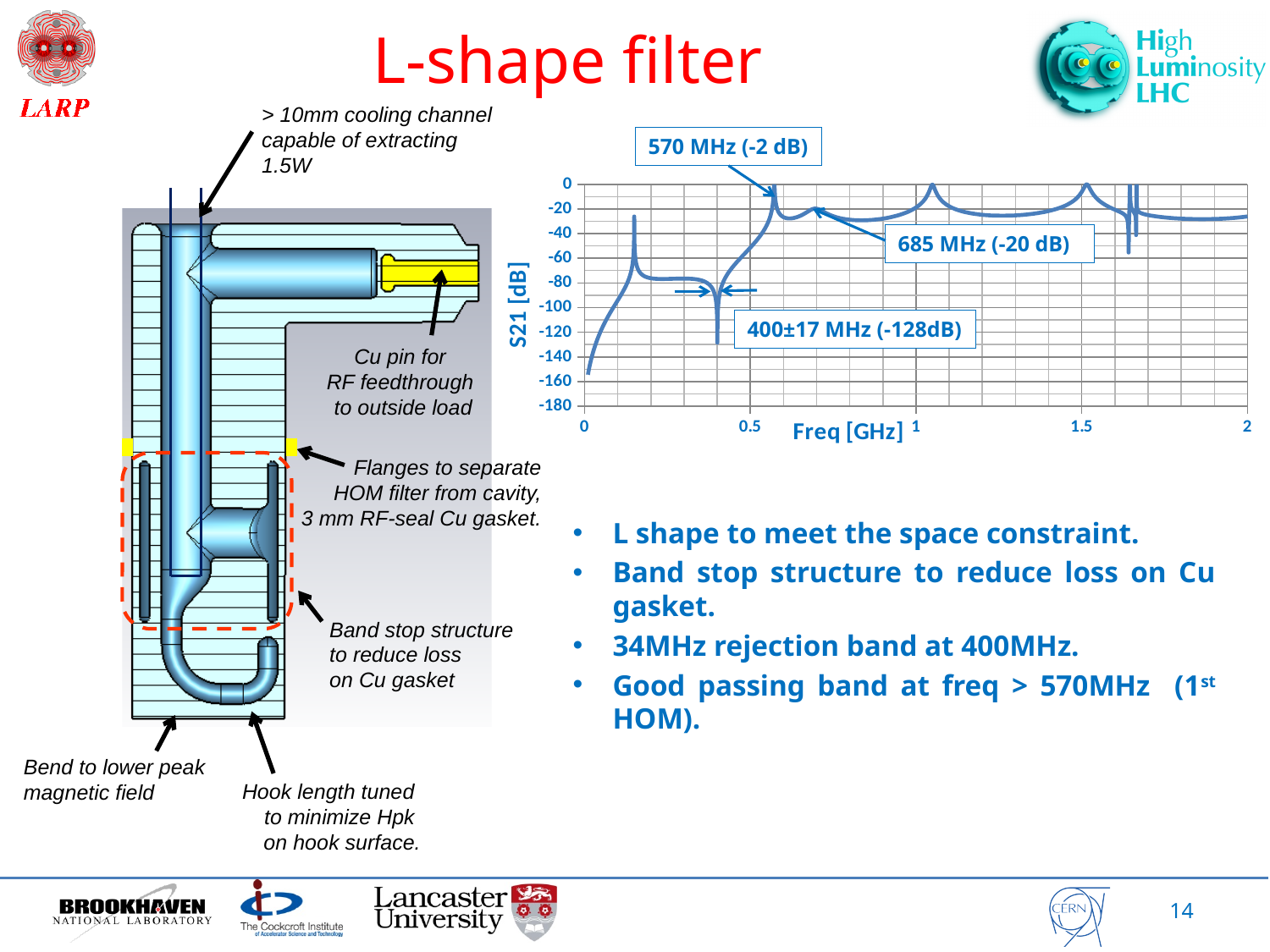
What is the label of the horizontal axis of the S21 chart? Freq [GHz] On the S21 chart, at which annotated frequency is the S21 value lowest? 400±17 MHz On the S21 chart, is the S21 value at the 400 MHz notch greater or less than -100 dB? less On the S21 chart, is the S21 value at 570 MHz greater or less than -20 dB? greater On the S21 chart, what is the difference in S21 between the 570 MHz point (-2 dB) and the 685 MHz point (-20 dB)? 18 dB What kind of chart is shown on the right side of the slide? line chart On the S21 chart, which annotated point has the higher S21 value: 570 MHz or 685 MHz? 570 MHz According to the annotation on the S21 chart, what is the S21 value at 685 MHz? -20 dB According to the annotation on the S21 chart, what is the S21 value at the 400±17 MHz notch? -128dB What is the lowest value shown on the vertical axis of the S21 chart? -180 What is the label of the vertical axis of the S21 chart? S21 [dB] According to the annotation on the S21 chart, what is the S21 value at 570 MHz? -2 dB